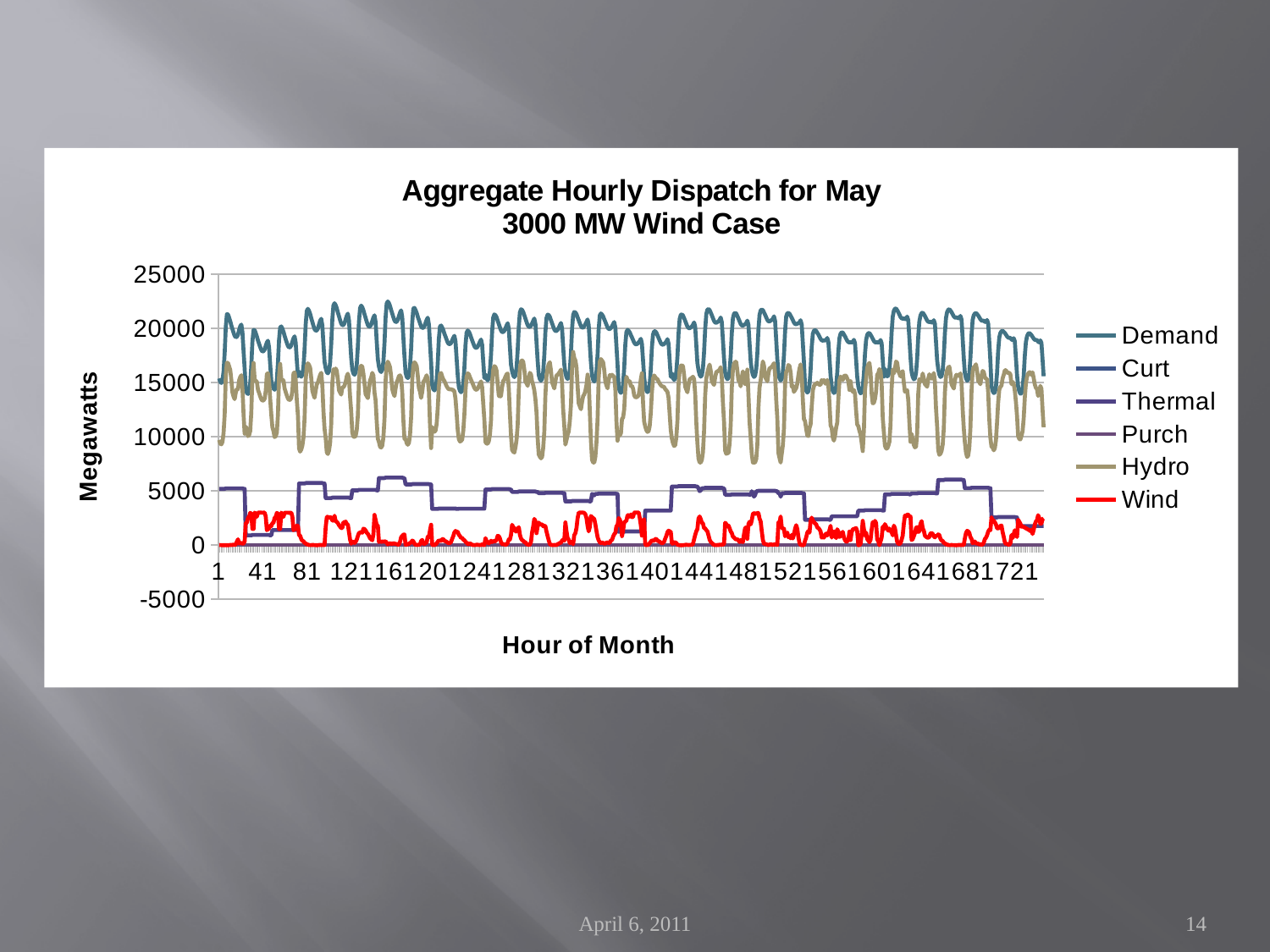
Is the highest value of the Hydro series greater or less than 20000? less How many series does the legend list? 6 Is the lowest value of the Demand series greater or less than 10000? greater What kind of chart is shown on the slide? line chart Is the highest value of the Wind series greater or less than 5000? less Which series is higher throughout the month, Thermal or Hydro? Hydro Which series reaches the highest values on the chart? Demand At hour 1, which is larger, the Demand value or the Hydro value? Demand What is the title of the chart? Aggregate Hourly Dispatch for May 3000 MW Wind Case What is the label of the x axis? Hour of Month